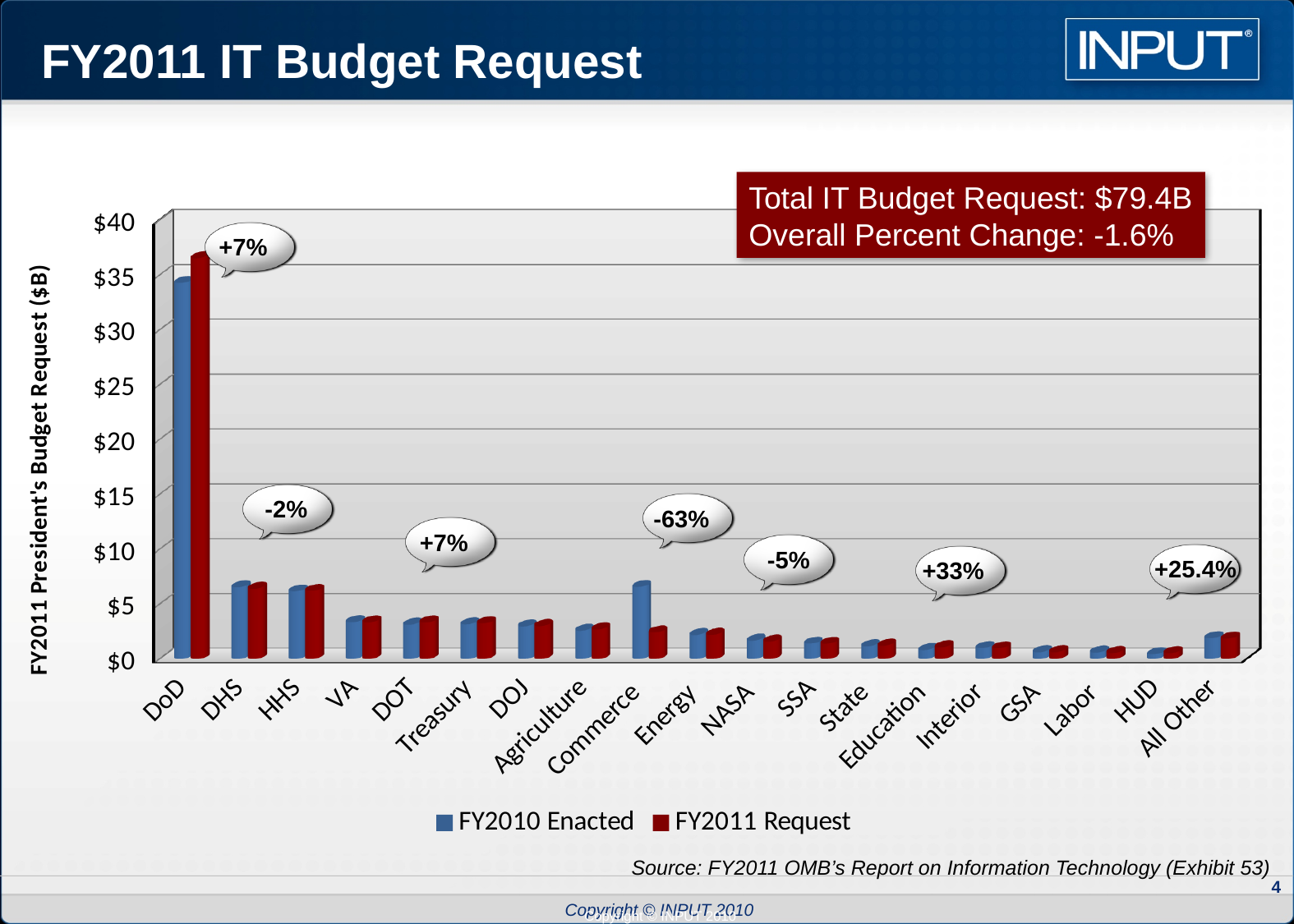
Is the FY2011 Request value for DHS greater or less than $10? less What kind of chart is shown on the slide? bar chart What total IT budget request is stated in the text box on the chart? $79.4B Which has a larger FY2011 Request value, DHS or VA? DHS Is the FY2010 Enacted value for DoD greater or less than $30? greater Which agency has the highest FY2011 Request value? DoD How many agency categories are shown on the x axis? 19 Do the FY2010 Enacted values generally rise or fall from DoD to HUD along the x axis? fall What percent change is shown in the callout above Education? +33% For Commerce, which is larger: the FY2010 Enacted value or the FY2011 Request value? FY2010 Enacted What percent change is shown in the callout above Commerce? -63% How many series does the legend list? 2